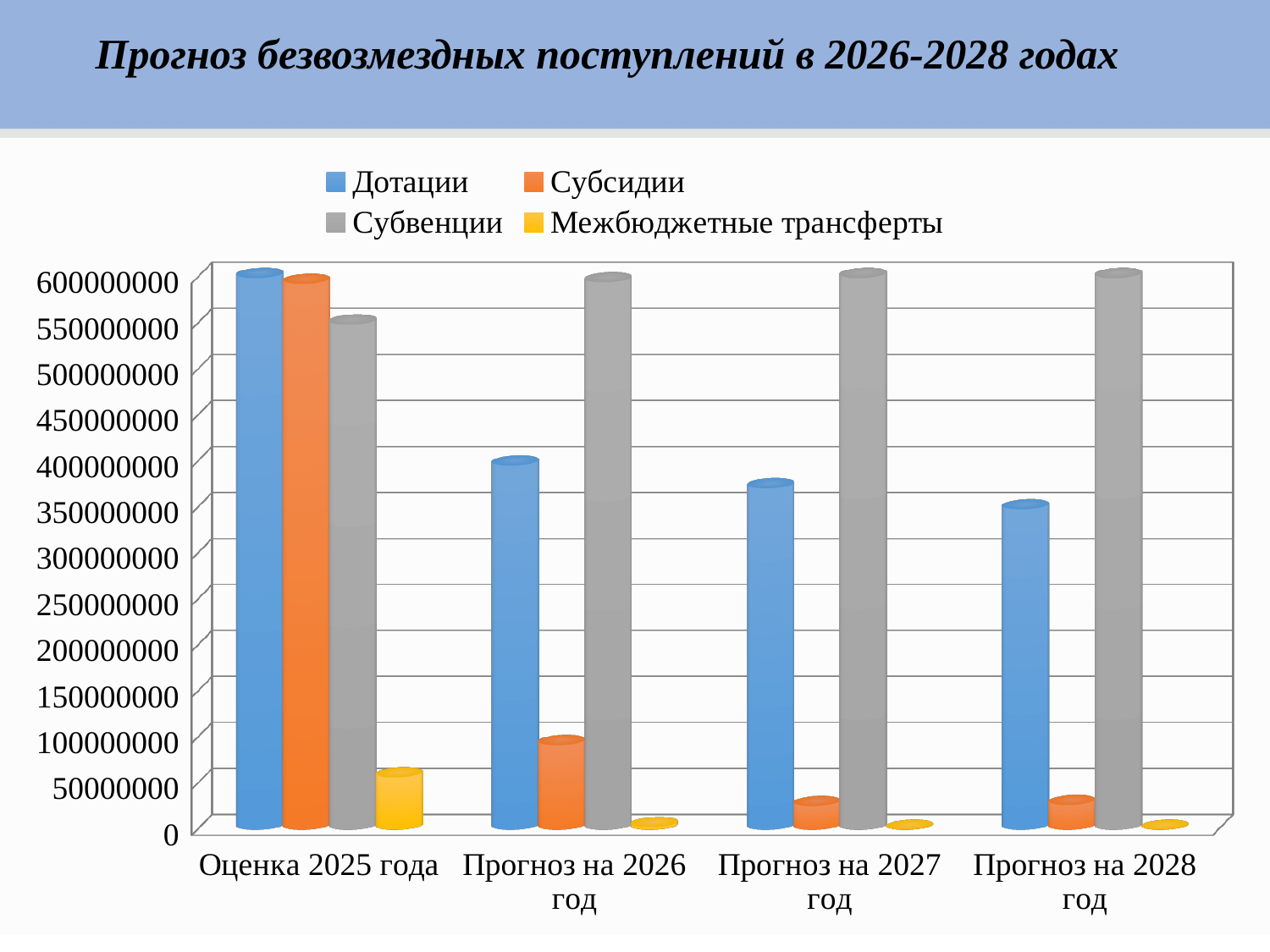
How many series does the legend list? 4 Is the value for Дотации in Прогноз на 2028 год greater or less than 400000000? less Is the value for Субсидии in Прогноз на 2026 год greater or less than 150000000? less In Прогноз на 2027 год, which is larger: Субвенции or Дотации? Субвенции Do the values for Дотации rise or fall from Оценка 2025 года to Прогноз на 2028 год? fall Which series has the lowest value in Прогноз на 2026 год? Межбюджетные трансферты In which category is the value for Субсидии highest? Оценка 2025 года What kind of chart is shown on the slide? bar chart What is the title of the slide? Прогноз безвозмездных поступлений в 2026-2028 годах Is the value for Дотации in Прогноз на 2026 год greater or less than 300000000? greater How many categories are shown along the x axis? 4